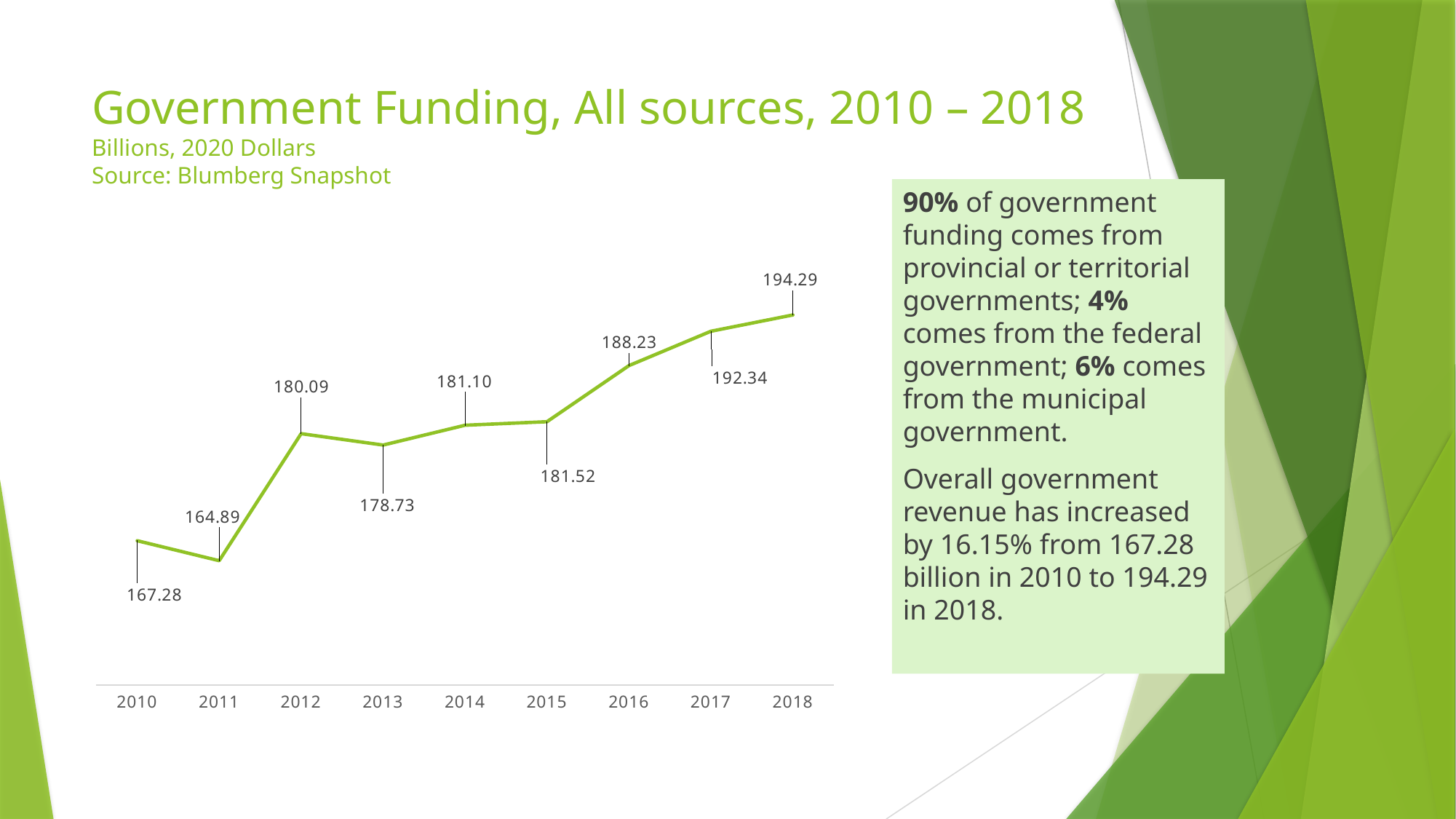
What is the government funding value for 2014? 181.10 What is the government funding value for 2017? 192.34 Which year has the highest government funding value? 2018 What is the title of the chart? Government Funding, All sources, 2010 – 2018 Which year has the lowest government funding value? 2011 Which year has a larger value, 2012 or 2016? 2016 What is the government funding value for 2011? 164.89 What kind of chart is shown on the slide? line chart What is the difference between the 2018 value and the 2010 value? 27.01 Do the values generally rise or fall from 2010 to 2018? rise What is the difference between the 2012 value and the 2013 value? 1.36 How many years are plotted on the x axis? 9